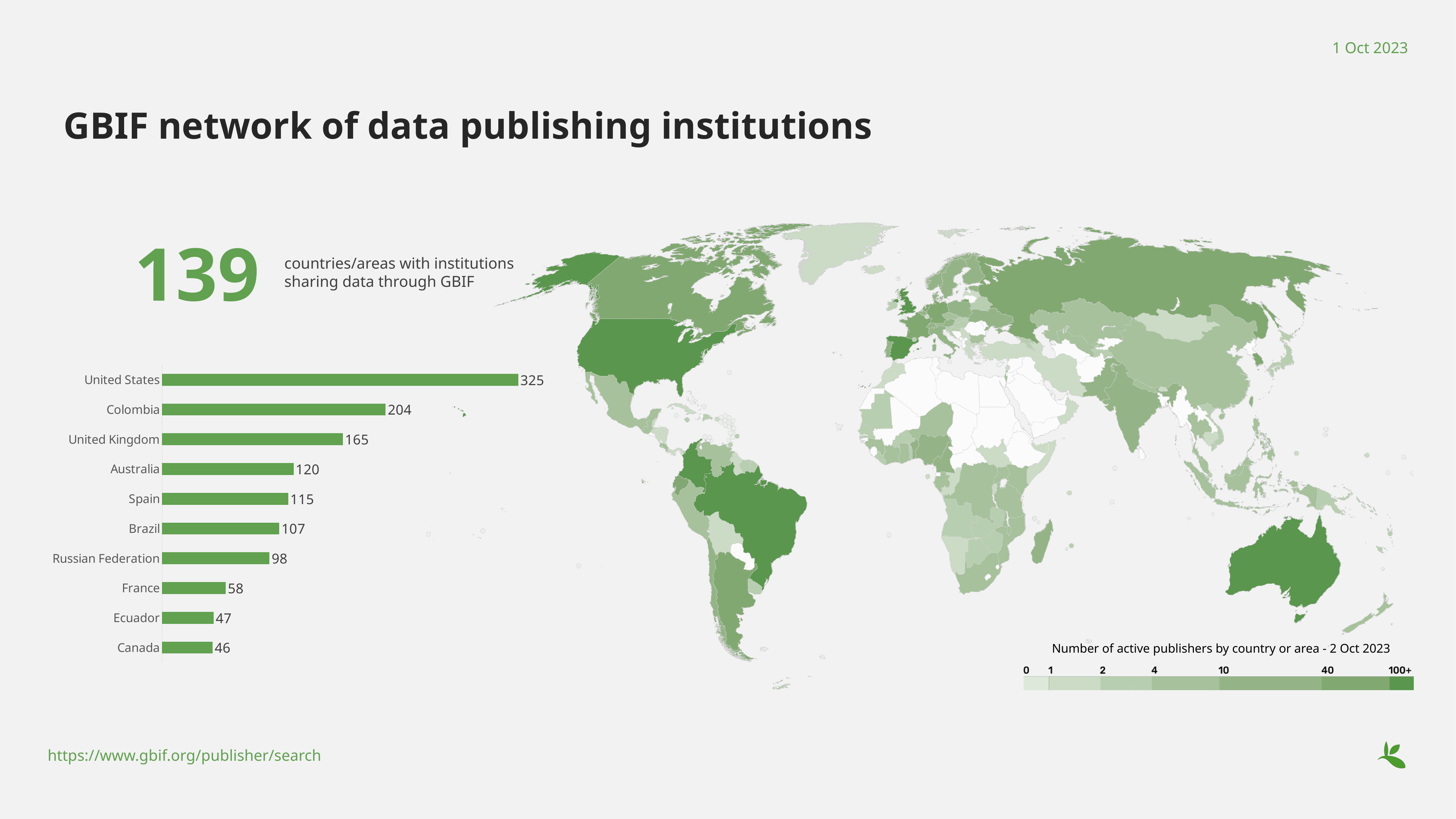
In the bar chart, which country has the highest value? United States How many countries are shown in the bar chart? 10 In the bar chart, which country has the lowest value? Canada In the bar chart, what is the difference between the values for Australia and Spain? 5 In the bar chart, how many active publishers does the United States have? 325 In the bar chart, which has a larger value, the United Kingdom or Brazil? United Kingdom What kind of chart is shown on the left of the slide? Bar chart What is the highest value shown on the map's colour legend? 100+ In the bar chart, which has a larger value, France or Ecuador? France In the bar chart, what is the value for Colombia? 204 In the bar chart, what is the value for the Russian Federation? 98 In the bar chart, what is the difference between the values for the United States and Colombia? 121